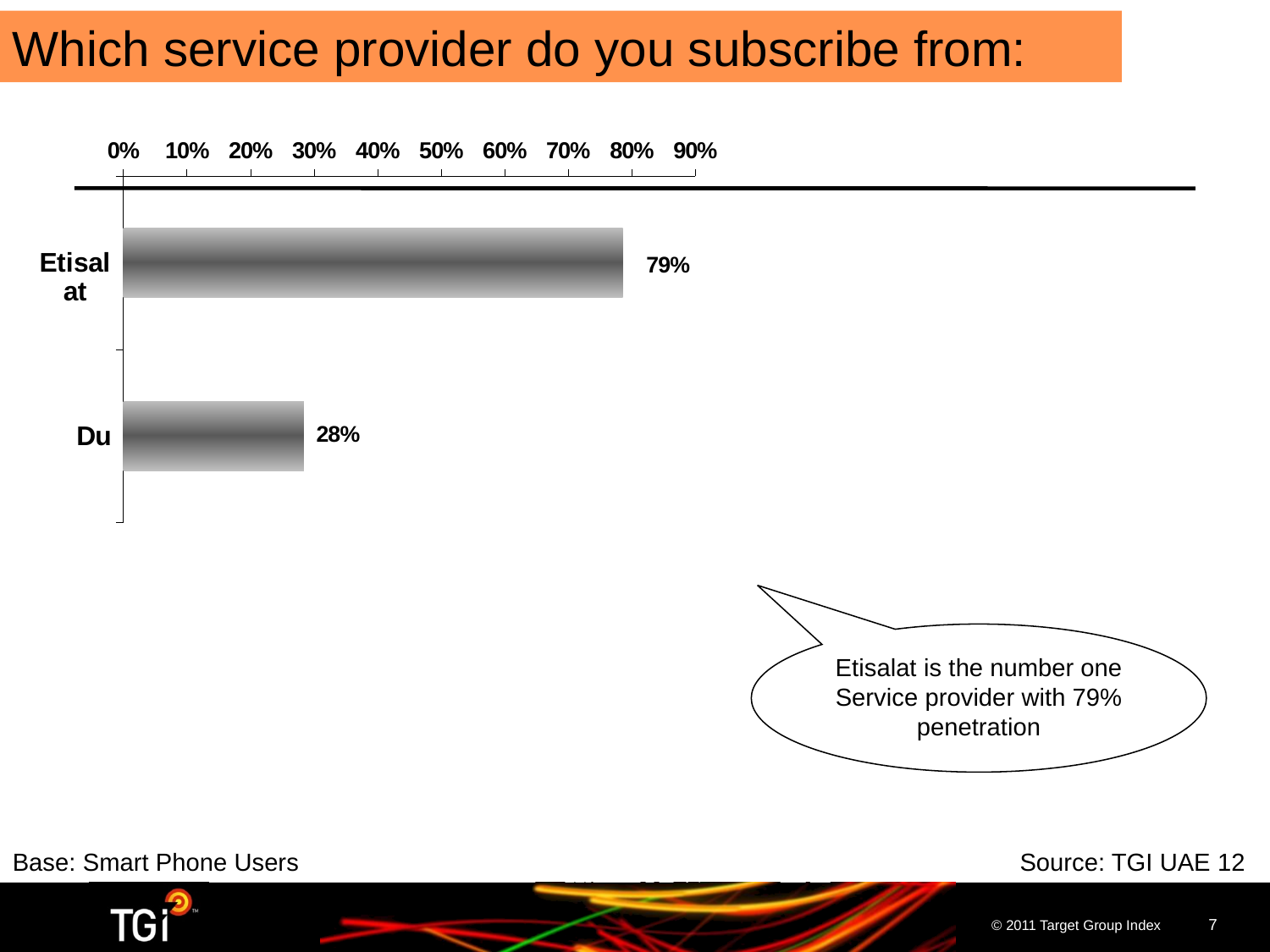
What is the highest value shown on the chart's axis? 90% What percentage of respondents subscribe from Du? 28% What is the base of respondents stated on the slide? Smart Phone Users What kind of chart is shown on the slide? Bar chart Which service provider has the highest share of subscribers? Etisalat Is the value for Du greater or less than 30%? less Is the value for Etisalat greater or less than 70%? greater What percentage of respondents subscribe from Etisalat? 79% Which is larger, the value for Etisalat or the value for Du? Etisalat Which service provider has the lowest share of subscribers? Du How many service providers are shown in the chart? 2 What is the difference in percentage points between Etisalat and Du? 51 percentage points